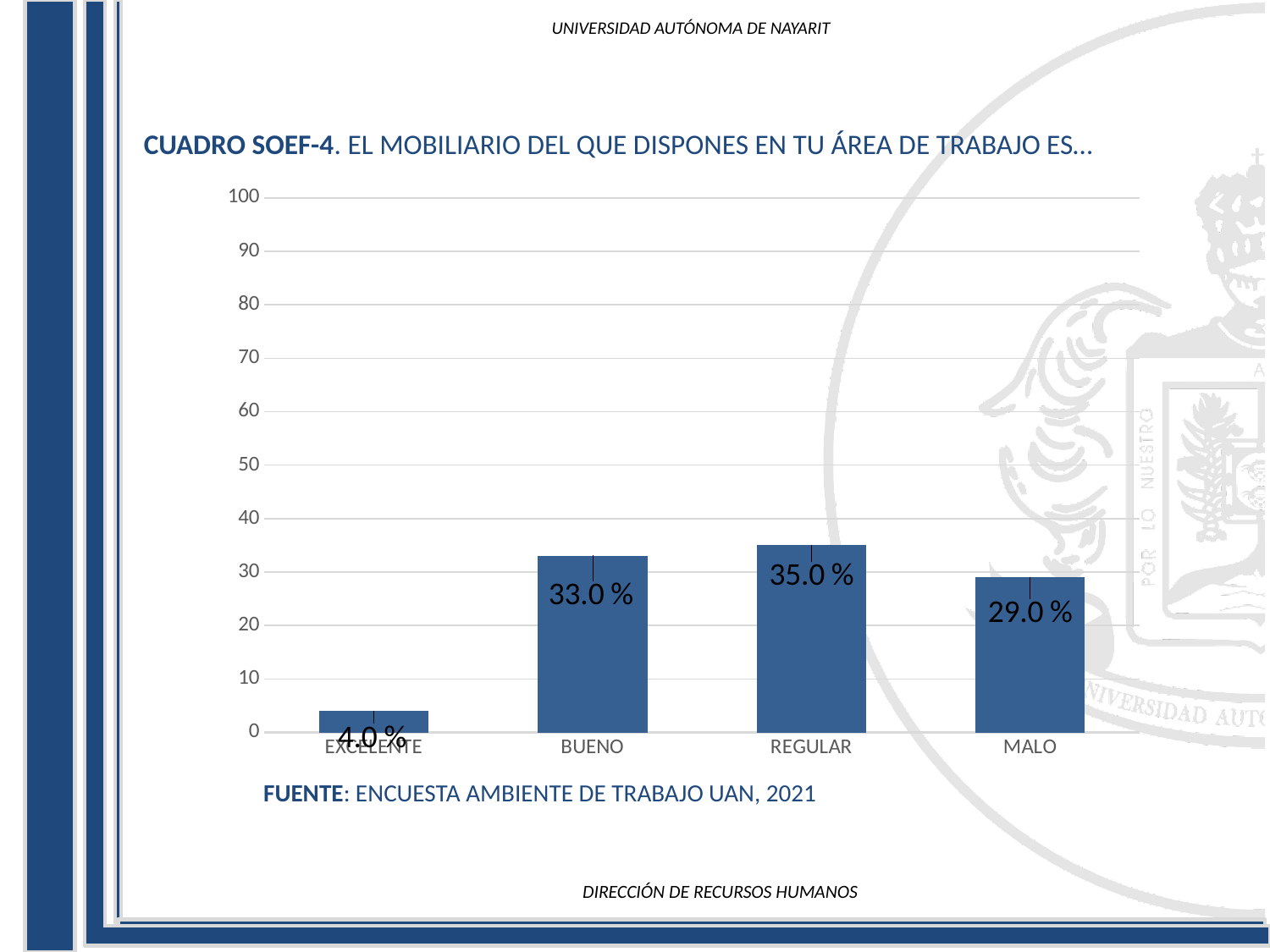
Which is larger, the value for BUENO or the value for MALO? BUENO What is the value for REGULAR? 35.0 % How many categories are shown on the x axis? 4 What is the value for MALO? 29.0 % Is the value for MALO greater or less than 20? greater What kind of chart is shown on the slide? bar chart What is the value for EXCELENTE? 4.0 % What is the source cited below the chart? ENCUESTA AMBIENTE DE TRABAJO UAN, 2021 Which category has the highest value? REGULAR What is the difference between the values for REGULAR and MALO? 6.0 % Which category has the lowest value? EXCELENTE What is the value for BUENO? 33.0 %